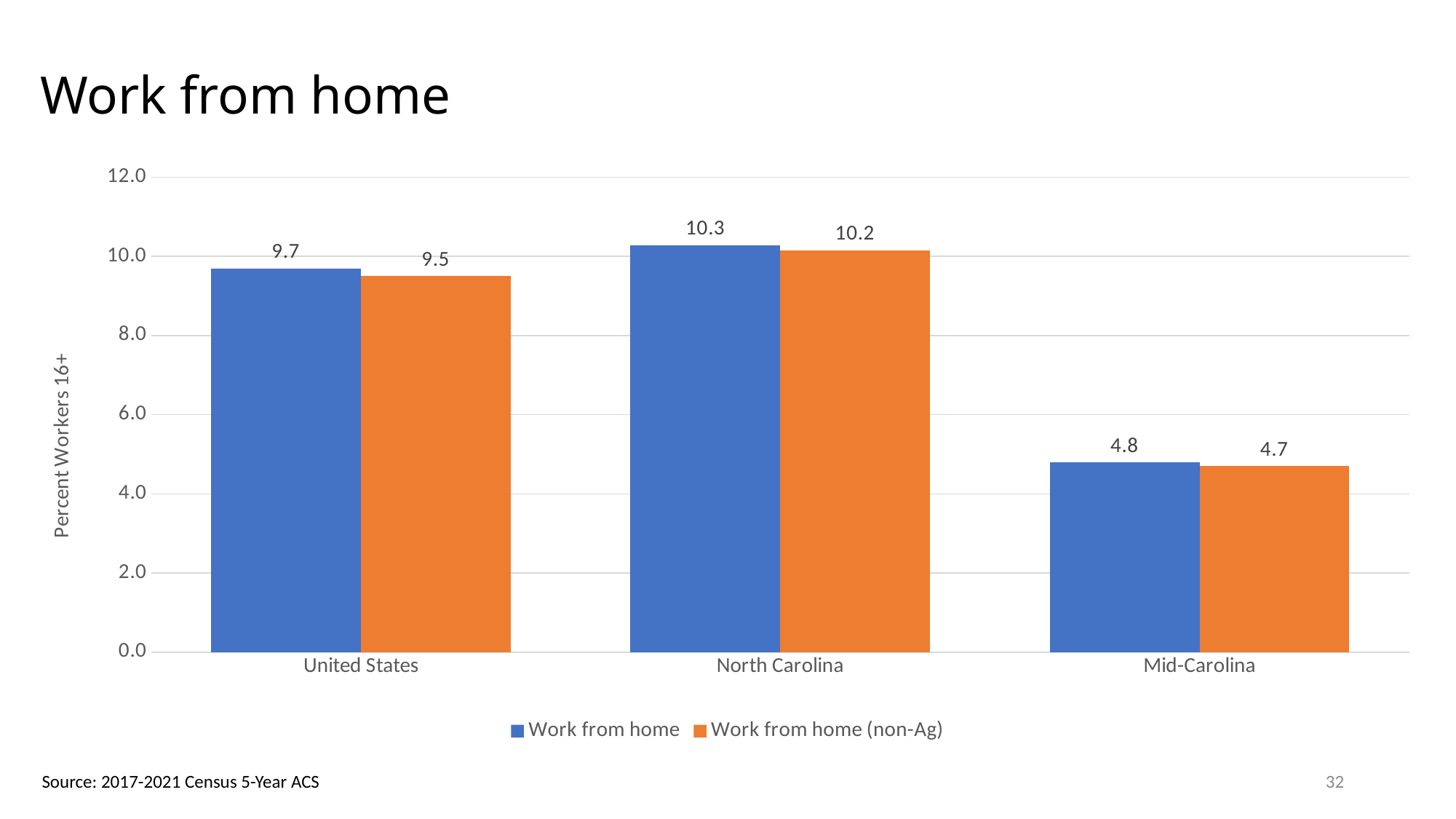
Which is larger: the 'Work from home' value for the United States or for Mid-Carolina? United States What kind of chart is shown on the slide? Bar chart What is the difference between the 'Work from home' values for North Carolina and Mid-Carolina? 5.5 How many categories are shown on the x axis? 3 What is the label of the vertical axis? Percent Workers 16+ What is the 'Work from home (non-Ag)' value for the United States? 9.5 Which category has the lowest 'Work from home (non-Ag)' value? Mid-Carolina How many series does the legend list? 2 What is the 'Work from home' value for North Carolina? 10.3 Which category has the highest 'Work from home' value? North Carolina What is the 'Work from home (non-Ag)' value for Mid-Carolina? 4.7 What is the difference between the 'Work from home' and 'Work from home (non-Ag)' values for the United States? 0.2